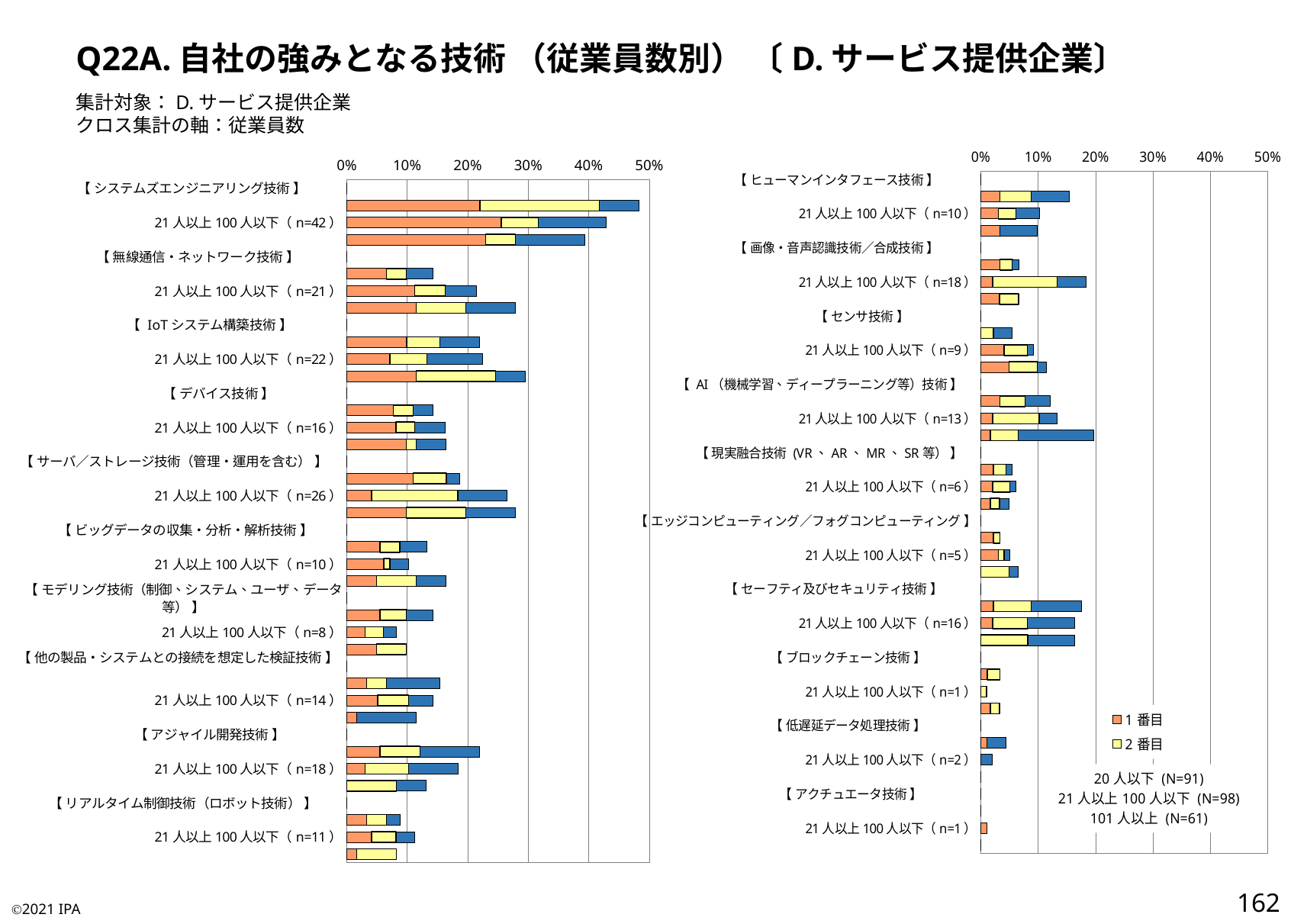
In the left chart, is the total bar for the first (20人以下) row under システムズエンジニアリング技術 greater or less than 40%? greater In the left chart, is the total bar for the 21人以上100人以下 (n=10) row under ビッグデータの収集・分析・解析技術 greater or less than 20%? less In the left chart, is the total bar for the third (101人以上) row under 無線通信・ネットワーク技術 greater or less than 20%? greater How many technology categories are shown in the right chart? 10 In the left chart, which technology category has the longest bars? システムズエンジニアリング技術 In the left chart, which is larger: the first-row bar for システムズエンジニアリング技術 or the first-row bar for リアルタイム制御技術（ロボット技術）? システムズエンジニアリング技術 How many technology categories are shown in the left chart? 10 What kind of chart is the left chart on the slide? bar chart What is the maximum value shown on the x axis of the right chart? 50% What are the two legend entries shown on the right chart? 1番目, 2番目